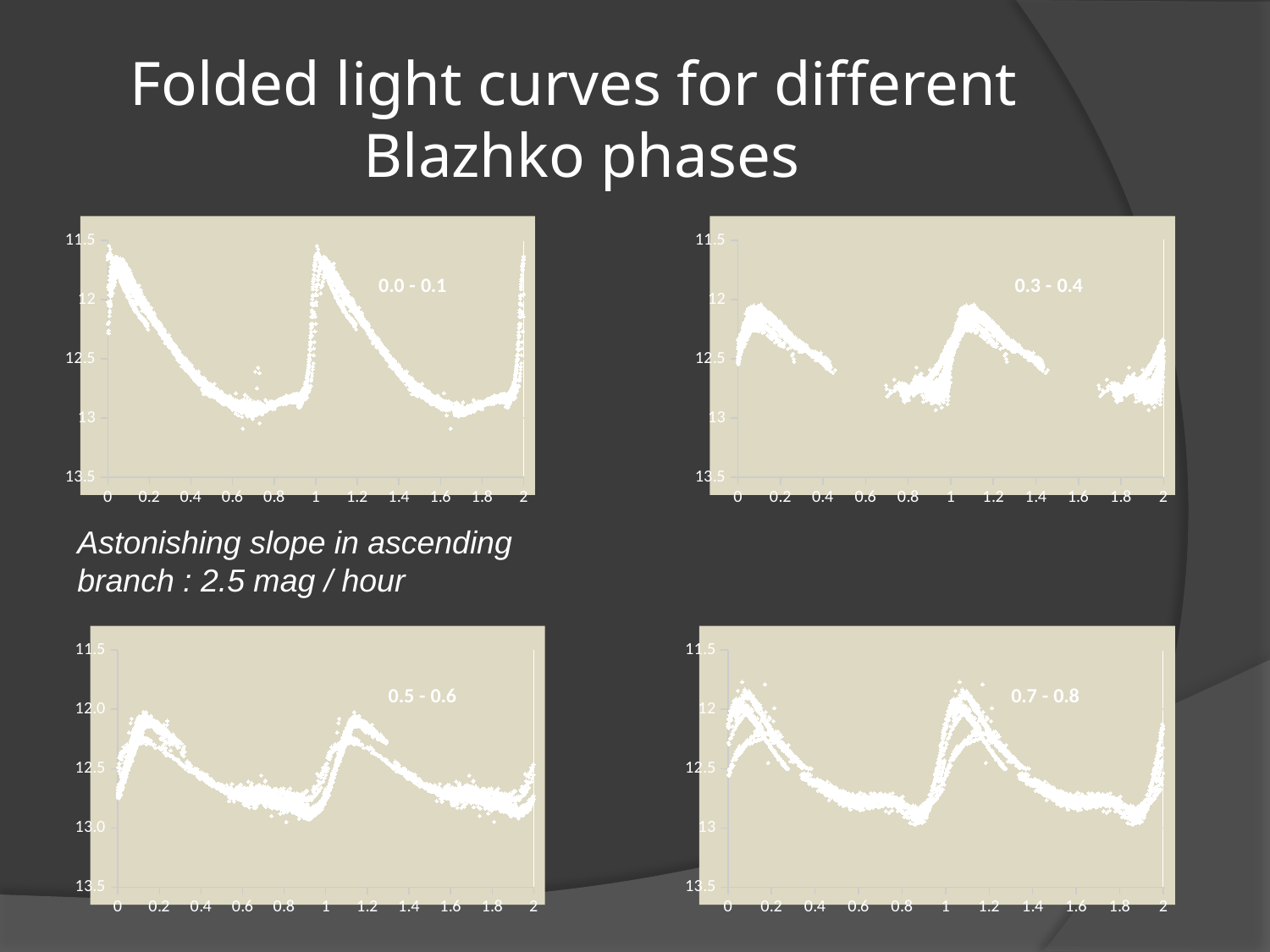
In the top-right chart (0.3 - 0.4), is the value at phase 0.8 greater or less than 12.5? greater In the top-left chart (0.0 - 0.1), is the value at the brightest peak near phase 1 greater or less than 12? less In the bottom-left chart (0.5 - 0.6), is the value at phase 0.6 greater or less than 12.5? greater What Blazhko phase label is printed inside the bottom-right chart? 0.7 - 0.8 How many charts are shown on the slide? 4 What Blazhko phase label is printed inside the top-right chart? 0.3 - 0.4 What kind of chart is the top-left chart labelled 0.0 - 0.1? scatter chart In the bottom-right chart (0.7 - 0.8), do the values rise or fall along the x axis between phase 0.1 and phase 0.6? rise In the top-left chart (0.0 - 0.1), do the values rise or fall along the x axis between phase 1 and phase 1.6? rise